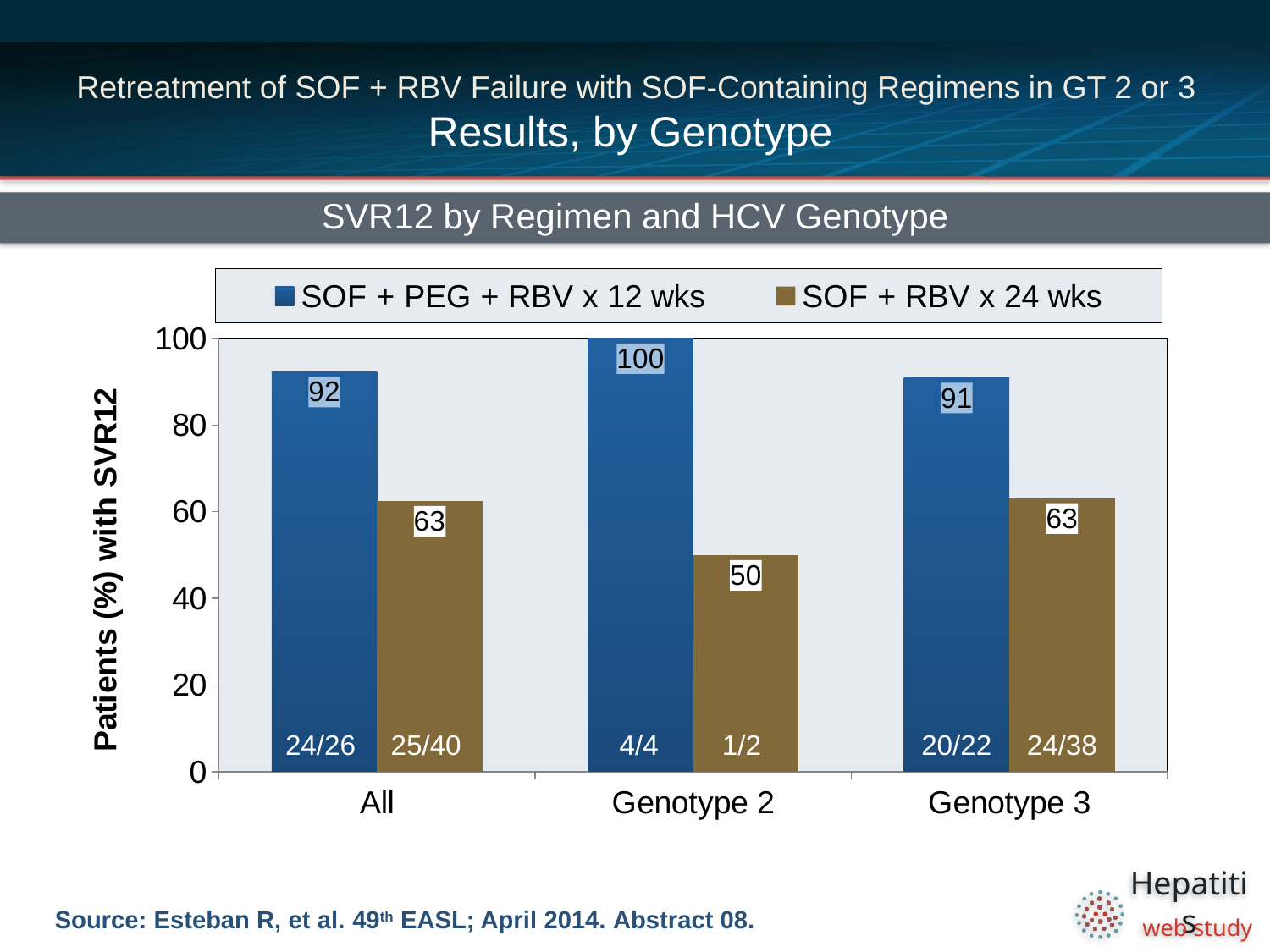
What is the SVR12 rate for SOF + RBV x 24 wks in Genotype 2? 50 Which category has the lowest SVR12 rate for SOF + RBV x 24 wks? Genotype 2 What is the SVR12 rate for SOF + PEG + RBV x 12 wks in Genotype 3? 91 What is the SVR12 rate for SOF + PEG + RBV x 12 wks in the All group? 92 What fraction of patients is shown for SOF + RBV x 24 wks in Genotype 3? 24/38 Which genotype category has the highest SVR12 rate for SOF + PEG + RBV x 12 wks? Genotype 2 What is the difference in SVR12 rate between SOF + PEG + RBV x 12 wks and SOF + RBV x 24 wks in the All group? 29 How many genotype categories are shown on the x axis? 3 How many series does the legend list? 2 In Genotype 3, which regimen has the higher SVR12 rate? SOF + PEG + RBV x 12 wks What is the label of the y axis? Patients (%) with SVR12 What kind of chart is shown on the slide? Bar chart